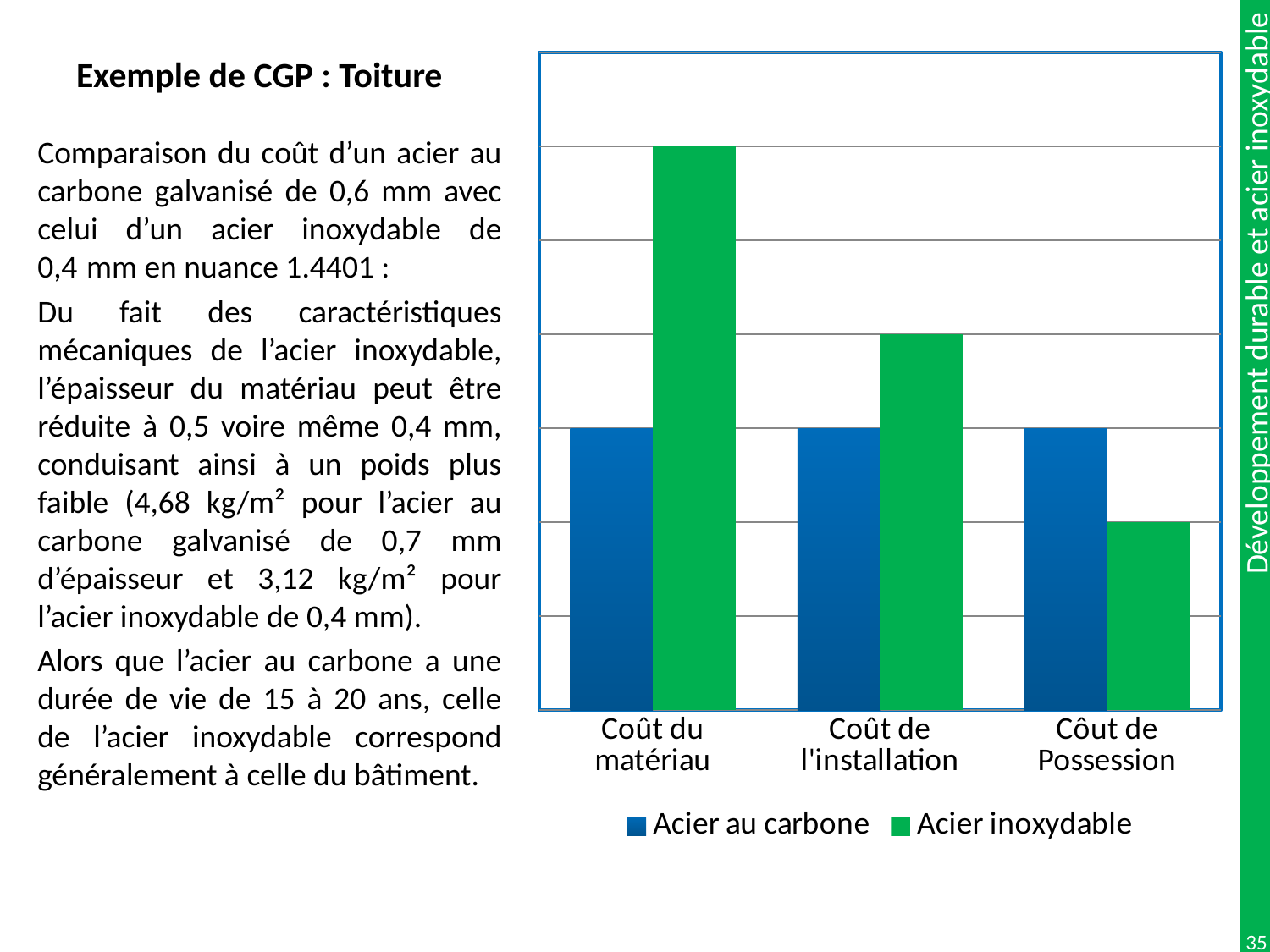
For Côut de Possession, which is larger: Acier au carbone or Acier inoxydable? Acier au carbone How many series does the chart's legend list? 2 For which category is the Acier inoxydable bar the lowest? Côut de Possession How many categories are shown on the x axis of the chart? 3 Which category has the largest gap between the Acier au carbone and Acier inoxydable bars? Coût du matériau For Coût de l'installation, which is larger: Acier au carbone or Acier inoxydable? Acier inoxydable Which series is shown in green in the chart? Acier inoxydable For which category is the Acier inoxydable bar the highest? Coût du matériau Do the Acier inoxydable values rise or fall from Coût du matériau to Côut de Possession? fall Which series is shown in blue in the chart? Acier au carbone What kind of chart is shown on the slide? bar chart